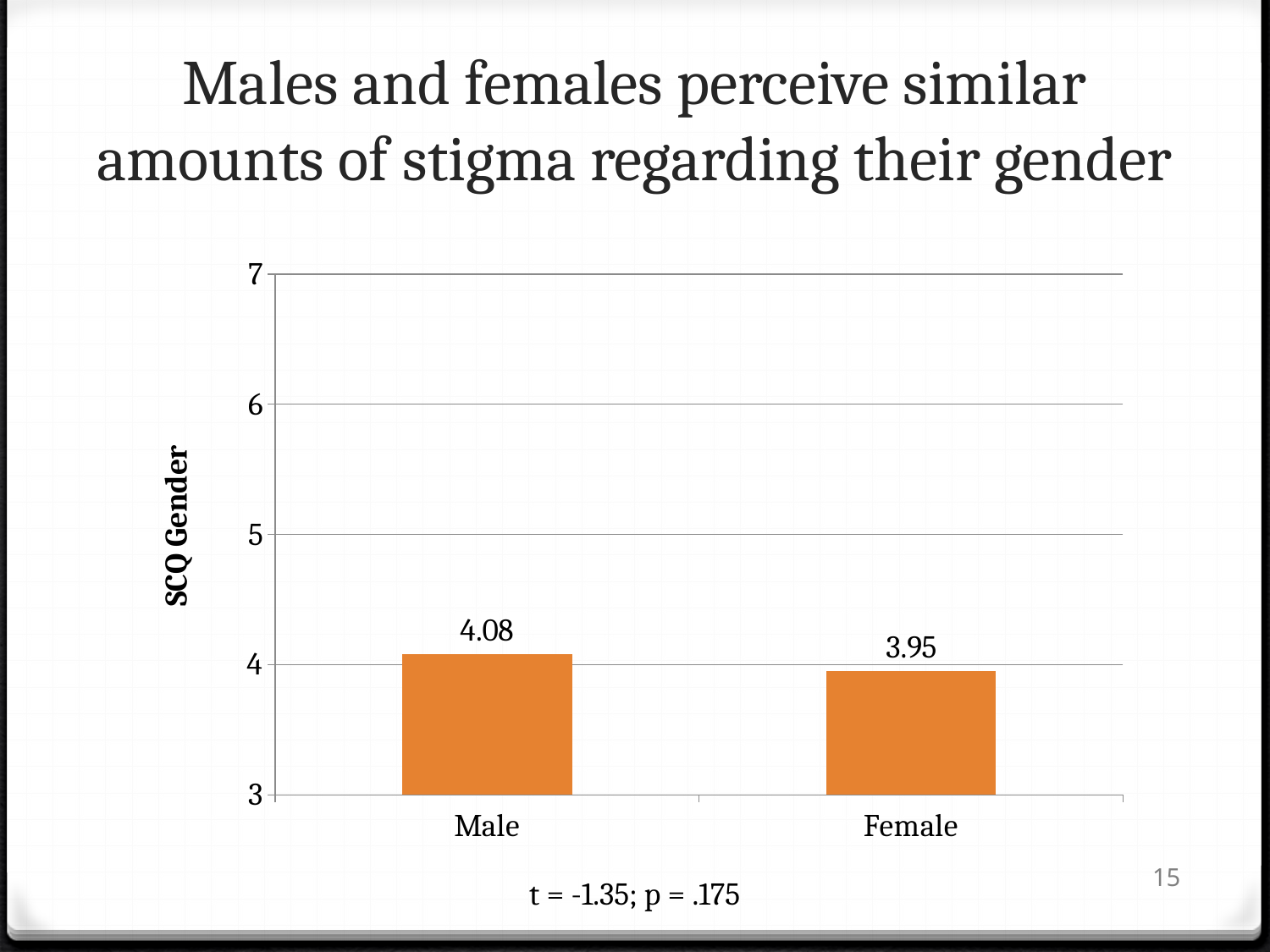
Is the value for Female greater or less than 4? less How many categories are shown on the x axis? 2 What is the label of the vertical axis? SCQ Gender Which category has the higher SCQ Gender value? Male What is the SCQ Gender value for Female? 3.95 What is the highest value shown on the vertical axis? 7 What kind of chart is shown on the slide? bar chart Which category has the lower SCQ Gender value? Female Is the value for Male greater or less than 4? greater What is the SCQ Gender value for Male? 4.08 Do the values rise or fall from Male to Female? fall What is the difference between the Male and Female SCQ Gender values? 0.13